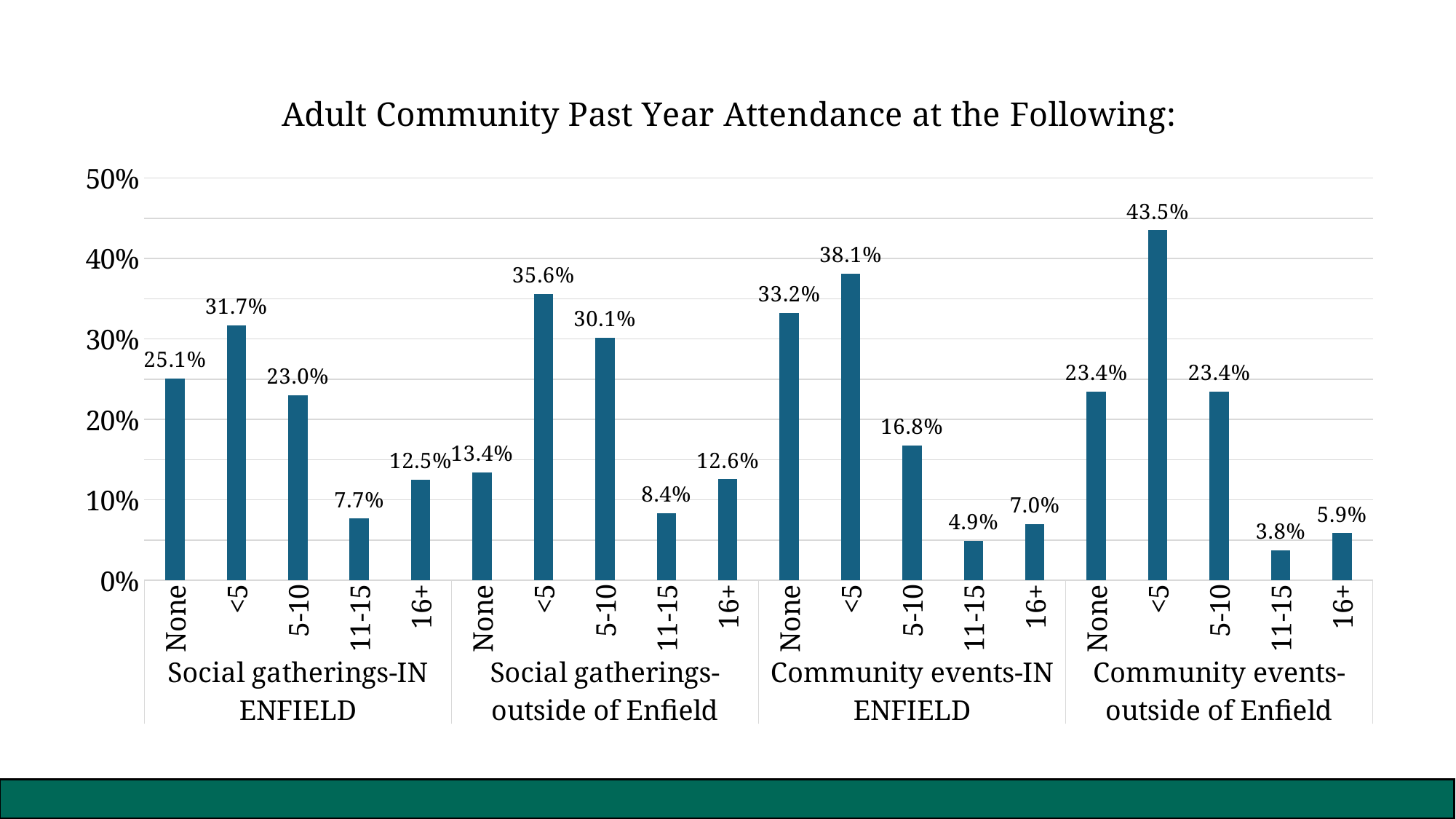
How many category groups are shown along the x axis? 4 What kind of chart is shown on the slide? bar chart Is the value for 'None' under 'Community events-IN ENFIELD' greater or less than 30%? greater What is the title of the chart? Adult Community Past Year Attendance at the Following: What is the value for '11-15' under 'Community events-IN ENFIELD'? 4.9% What is the value for '<5' under 'Community events-outside of Enfield'? 43.5% What is the difference between '<5' and 'None' under 'Social gatherings-outside of Enfield'? 22.2% What is the value for 'None' under 'Social gatherings-IN ENFIELD'? 25.1% Which bar has the lowest value on the chart? 11-15 under Community events-outside of Enfield Which bar has the highest value on the chart? <5 under Community events-outside of Enfield Which is larger: '5-10' under 'Social gatherings-IN ENFIELD' or '5-10' under 'Social gatherings-outside of Enfield'? 5-10 under Social gatherings-outside of Enfield How many bars are plotted on the chart in total? 20